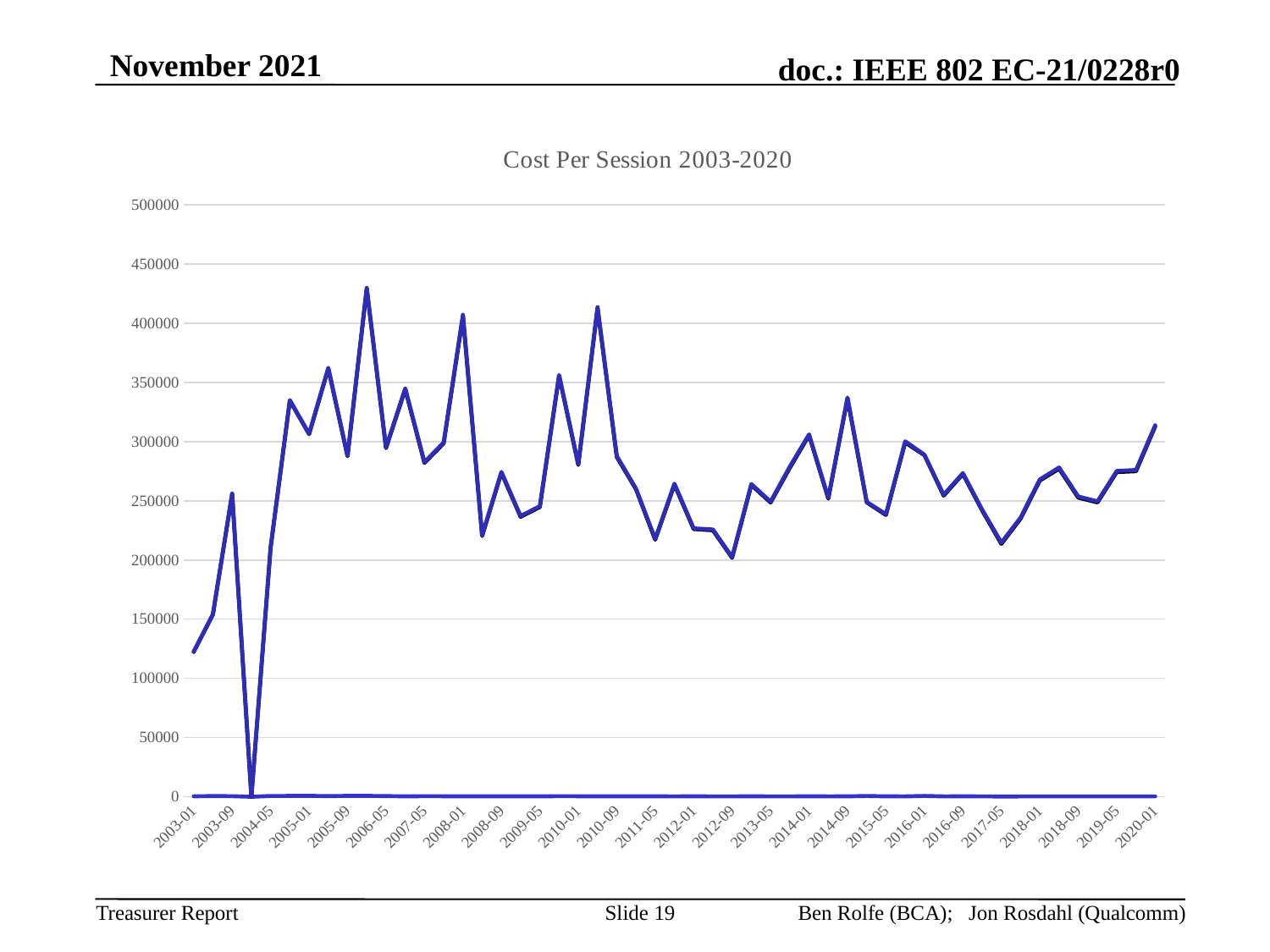
Which is larger, the value for 2003-01 or the value for 2020-01? 2020-01 Is the value for 2020-01 greater or less than 250000? greater What is the lowest value the line reaches? 0 Is the value for 2008-01 greater or less than 350000? greater What kind of chart is shown on the slide? line chart Is the value for 2014-09 greater or less than 300000? greater Between 2003-01 and 2003-09, does the line rise or fall? rise What is the title of the chart? Cost Per Session 2003-2020 What is the highest value shown on the y axis? 500000